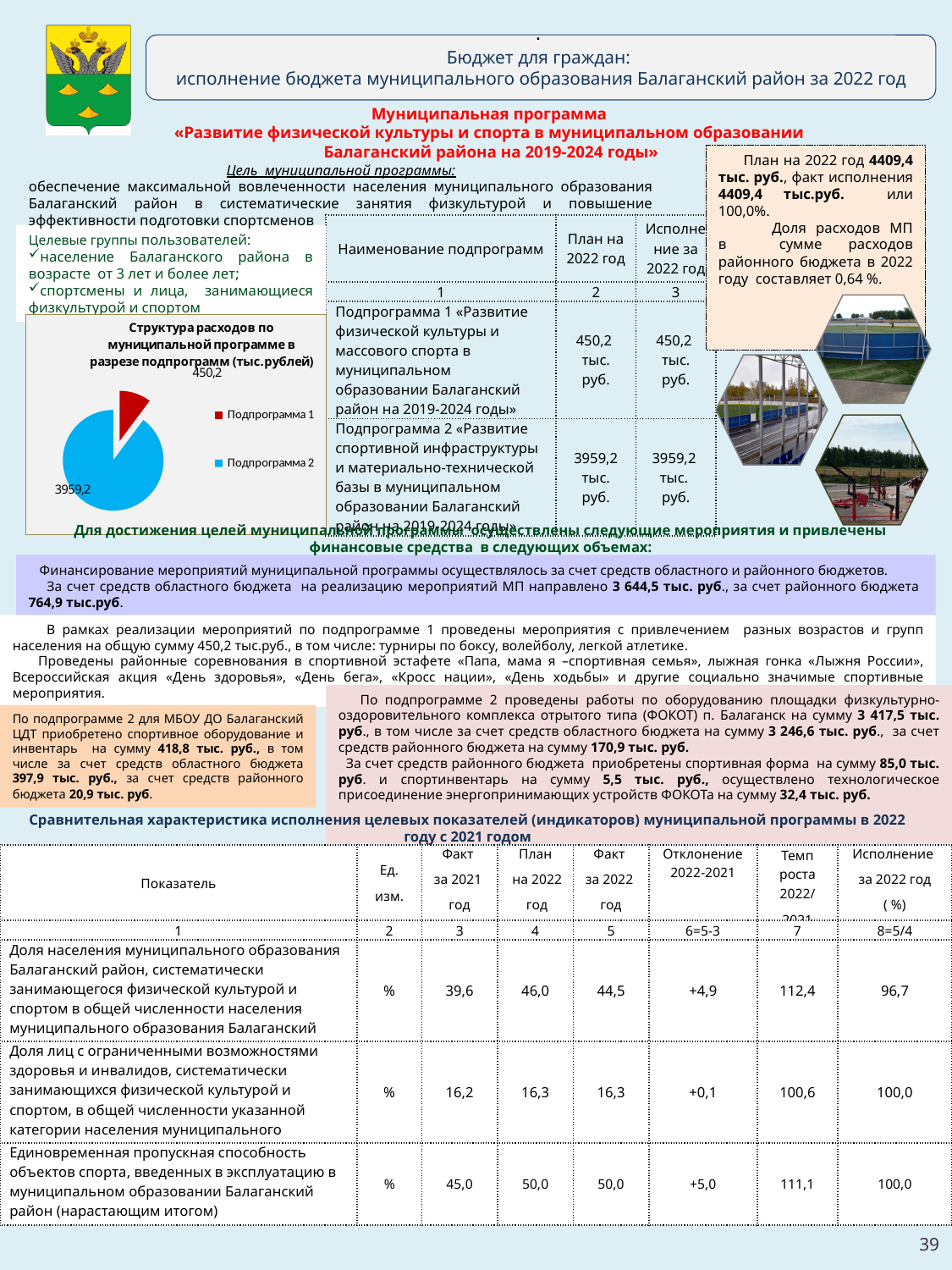
How many entries does the legend of the pie chart list? 2 In the pie chart, which is larger: the value for Подпрограмма 1 or for Подпрограмма 2? Подпрограмма 2 Which subprogram has the smallest slice in the pie chart? Подпрограмма 1 In the pie chart, what is the value for Подпрограмма 2? 3959,2 What colour is the slice for Подпрограмма 1 in the pie chart? red What type of chart is shown under the title «Структура расходов по муниципальной программе в разрезе подпрограмм (тыс.рублей)»? pie chart What is the difference between the values for Подпрограмма 2 and Подпрограмма 1 in the pie chart? 3509,0 In the pie chart, what is the value for Подпрограмма 1? 450,2 What unit is stated in the title of the pie chart? тыс.рублей What is the total of the two slices in the pie chart? 4409,4 How many slices does the pie chart have? 2 Which subprogram has the largest slice in the pie chart? Подпрограмма 2